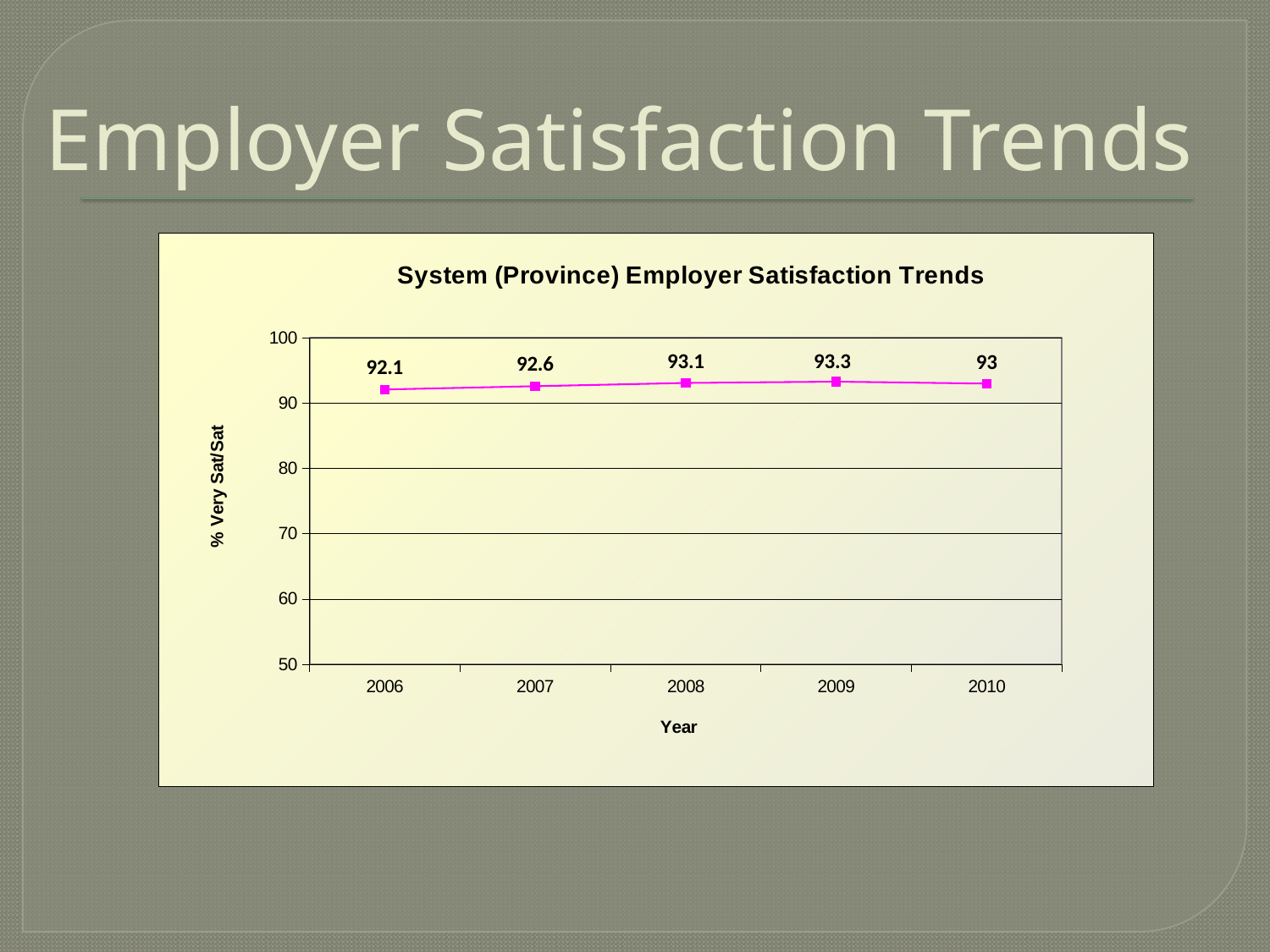
What is the value for 2008? 93.1 What is the value for 2006? 92.1 What kind of chart is shown? line chart What is the difference between the values for 2009 and 2006? 1.2 Which is larger, the value for 2007 or the value for 2010? 2010 What is the value for 2010? 93 Do the values rise or fall from 2006 to 2009? rise Which year has the lowest value? 2006 Which year has the highest value? 2009 What is the title of the chart? System (Province) Employer Satisfaction Trends Is the value for 2007 greater or less than 90? greater How many years are plotted on the chart? 5